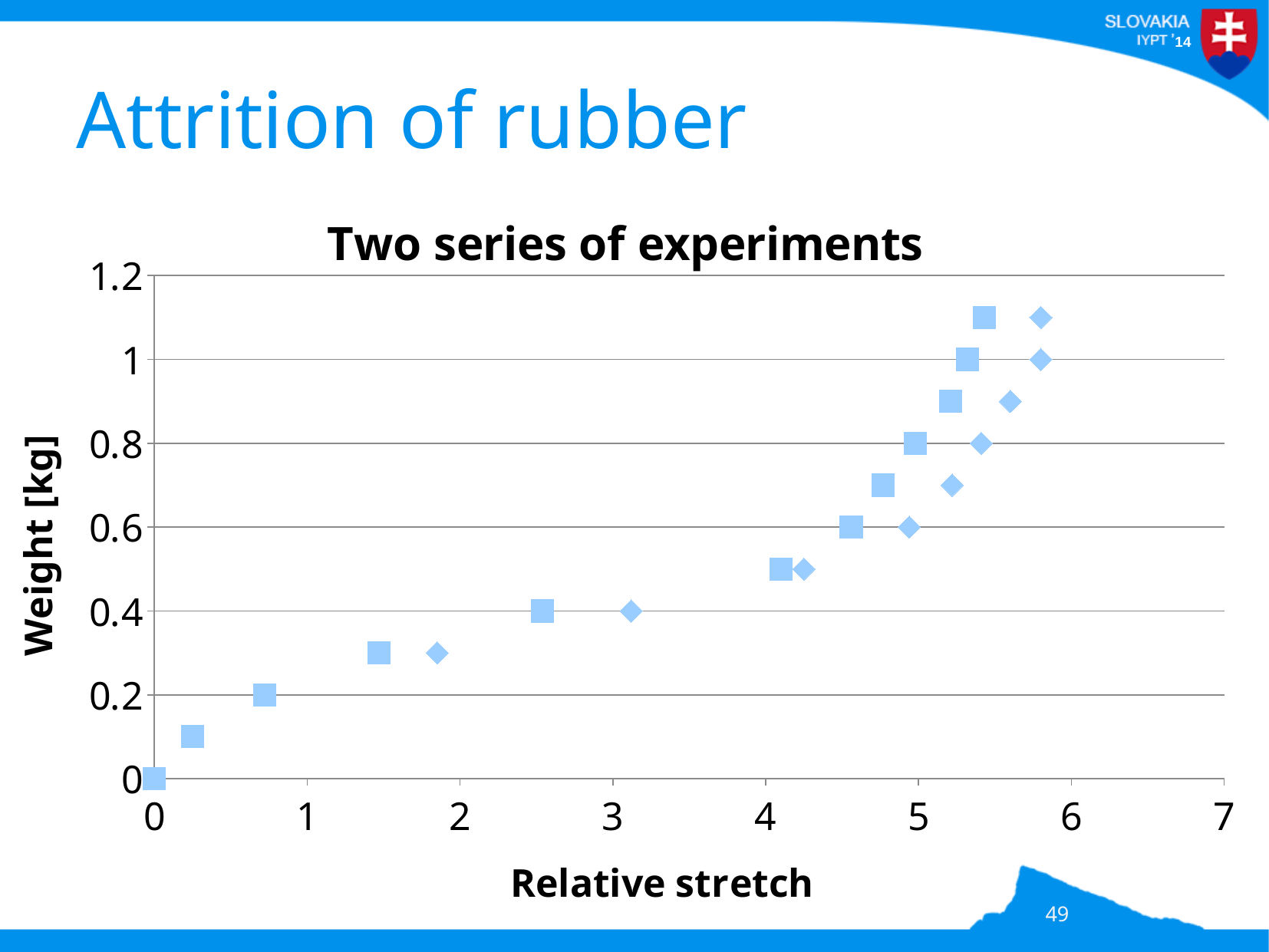
Is the relative stretch of the diamond marker at a weight of 1 kg greater or less than 5? greater What kind of chart is shown on the slide? Scatter chart How many diamond markers are plotted on the chart? 9 Is the relative stretch of the square marker at a weight of 0.4 kg greater or less than 3? less Is the relative stretch of the square marker at a weight of 0.6 kg greater or less than 5? less At a weight of 0.4 kg, which series has the larger relative stretch, the squares or the diamonds? Diamonds How many square markers are plotted on the chart? 12 What is the weight of the lowest square marker on the chart? 0 What is the highest value shown on the vertical axis? 1.2 What is the title of the chart? Two series of experiments Does the weight rise or fall as relative stretch increases? Rises What is the label of the vertical axis? Weight [kg]